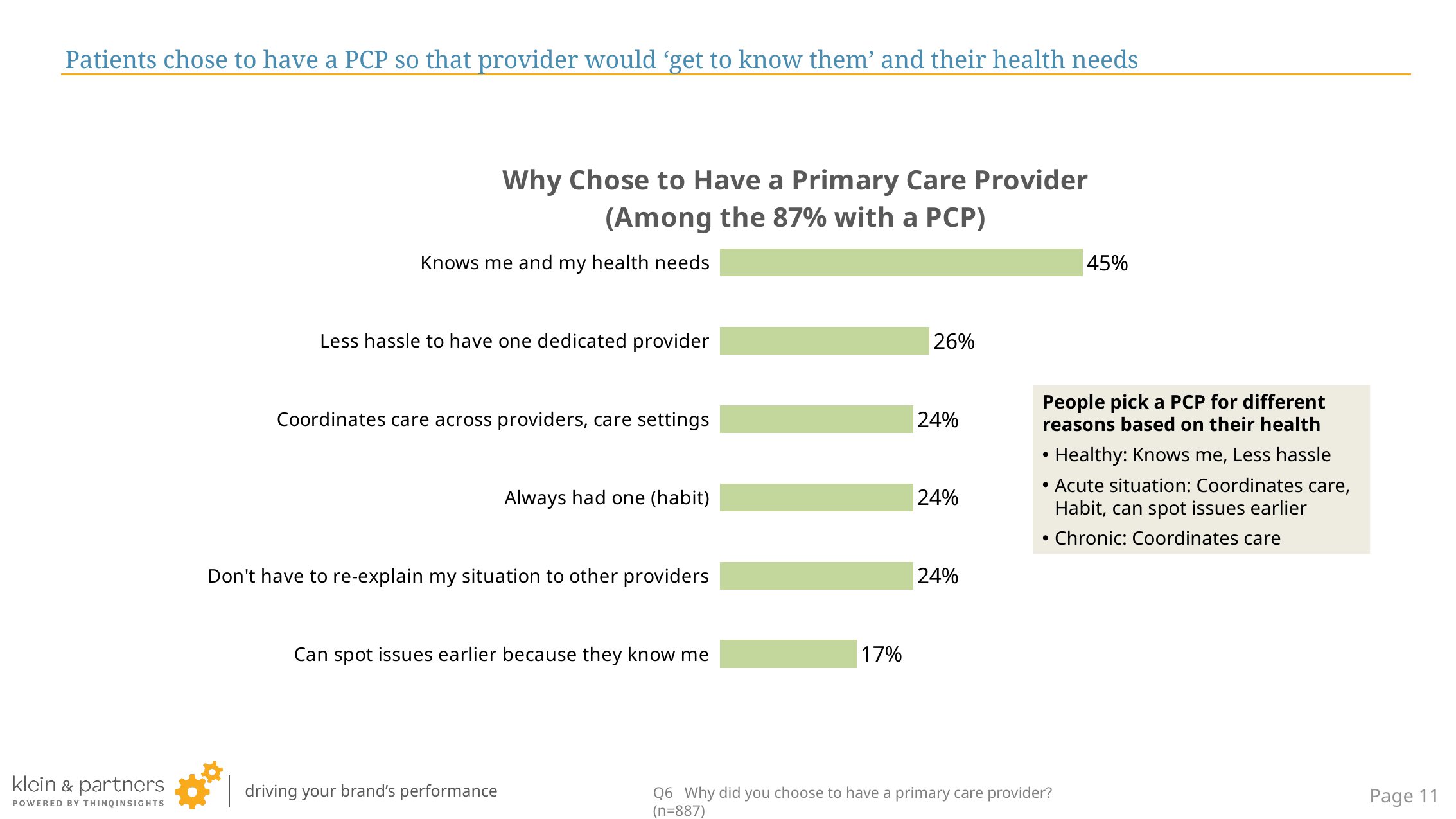
What percentage chose a PCP because the provider 'Knows me and my health needs'? 45% Which reason has the highest percentage? Knows me and my health needs What is the value for 'Less hassle to have one dedicated provider'? 26% Which is larger: 'Less hassle to have one dedicated provider' or 'Coordinates care across providers, care settings'? Less hassle to have one dedicated provider What kind of chart is shown on the slide? Bar chart Which reason has the lowest percentage? Can spot issues earlier because they know me What is the title of the chart? Why Chose to Have a Primary Care Provider (Among the 87% with a PCP) What is the value for 'Always had one (habit)'? 24% What is the difference between 'Knows me and my health needs' and 'Less hassle to have one dedicated provider'? 19 percentage points What is the difference between 'Less hassle to have one dedicated provider' and 'Can spot issues earlier because they know me'? 9 percentage points How many reasons are shown in the chart? 6 What is the value for 'Can spot issues earlier because they know me'? 17%